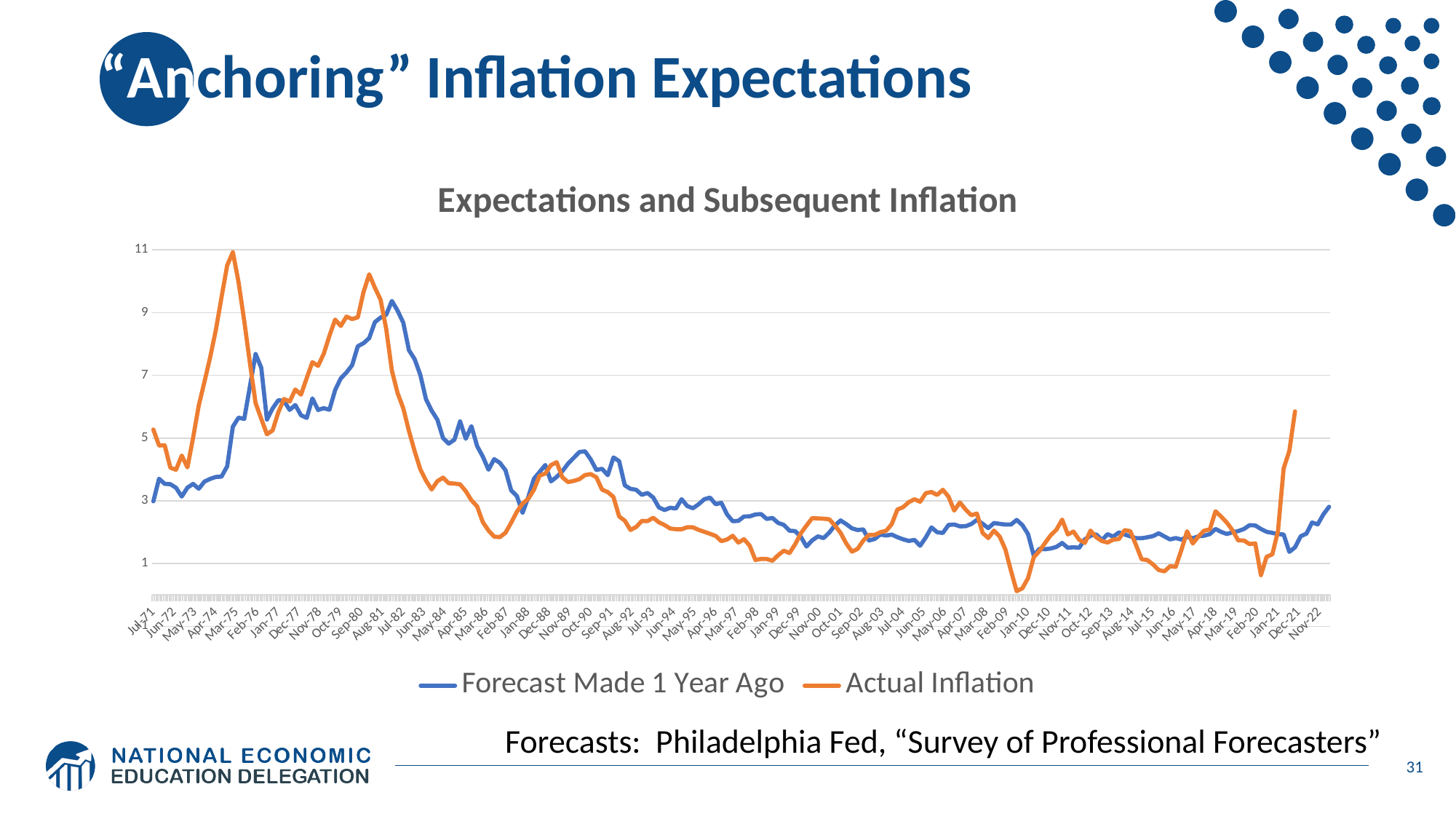
Around Jan-10, which series is higher, Forecast Made 1 Year Ago or Actual Inflation? Forecast Made 1 Year Ago What kind of chart is shown on the slide? Line chart Is the peak value of Actual Inflation around Mar-75 greater or less than 9? greater Around Mar-75, which series is higher, Forecast Made 1 Year Ago or Actual Inflation? Actual Inflation Is the value of Actual Inflation around Jan-10 greater or less than 1? less Is the value of Forecast Made 1 Year Ago at Nov-22 greater or less than 5? less Does Actual Inflation rise or fall between Feb-20 and Dec-21? Rise Which series is drawn in orange? Actual Inflation What is the title of the chart? Expectations and Subsequent Inflation How many series does the legend list? 2 Which series reaches the highest value anywhere on the chart? Actual Inflation